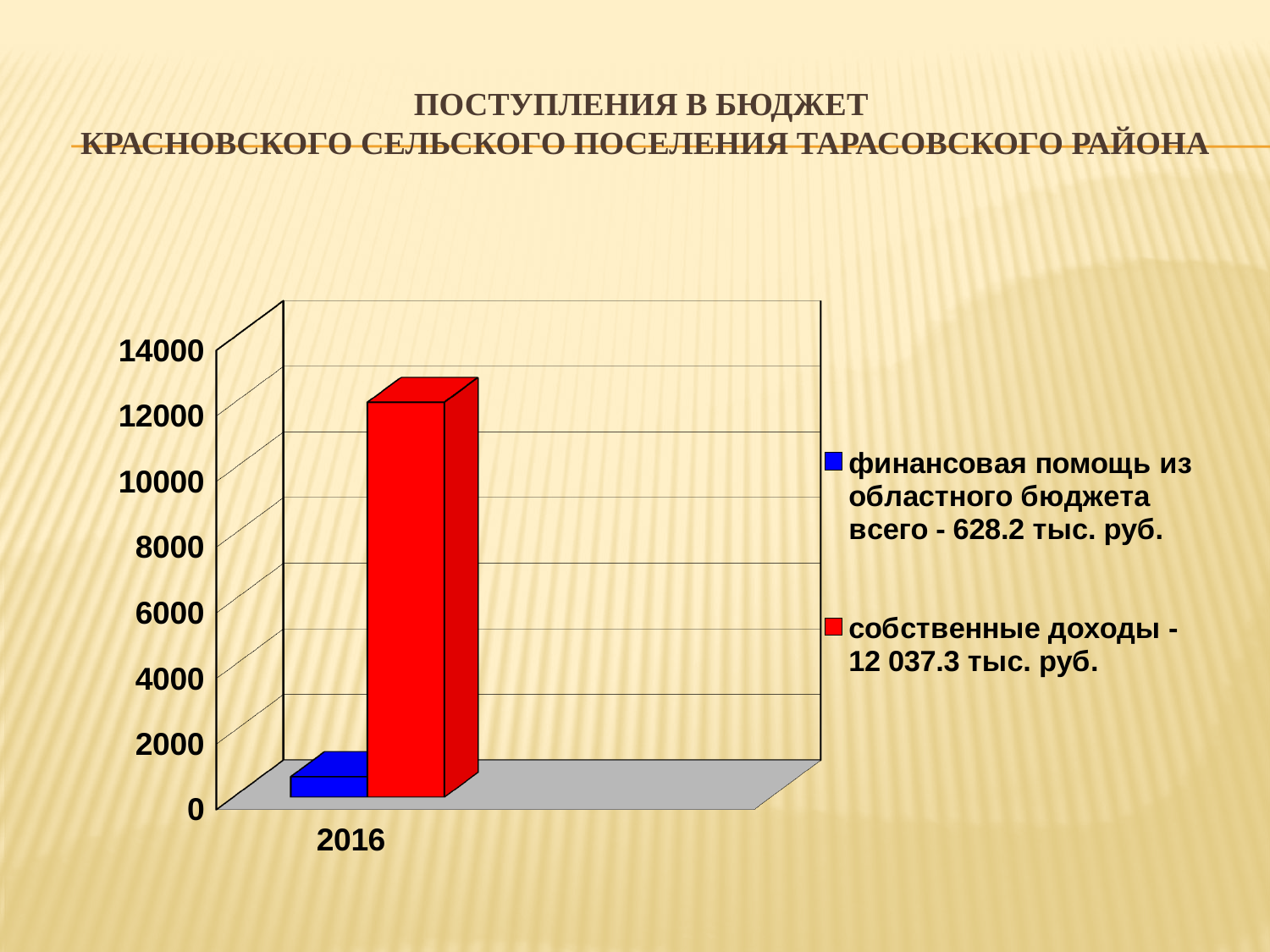
What type of chart is shown on the slide? bar chart Which series has the lower value in 2016? финансовая помощь из областного бюджета Which series has the higher value in 2016? собственные доходы How many series does the legend list? 2 What is the difference between собственные доходы and финансовая помощь из областного бюджета? 11 409.1 тыс. руб. Which year is shown on the x axis? 2016 Is the value for финансовая помощь из областного бюджета greater or less than 2000? less How many categories are shown on the x axis? 1 What colour is the bar for собственные доходы? red What is the value of собственные доходы according to the legend? 12 037.3 тыс. руб. What is the value of финансовая помощь из областного бюджета according to the legend? 628.2 тыс. руб. Is the value for собственные доходы greater or less than 10000? greater